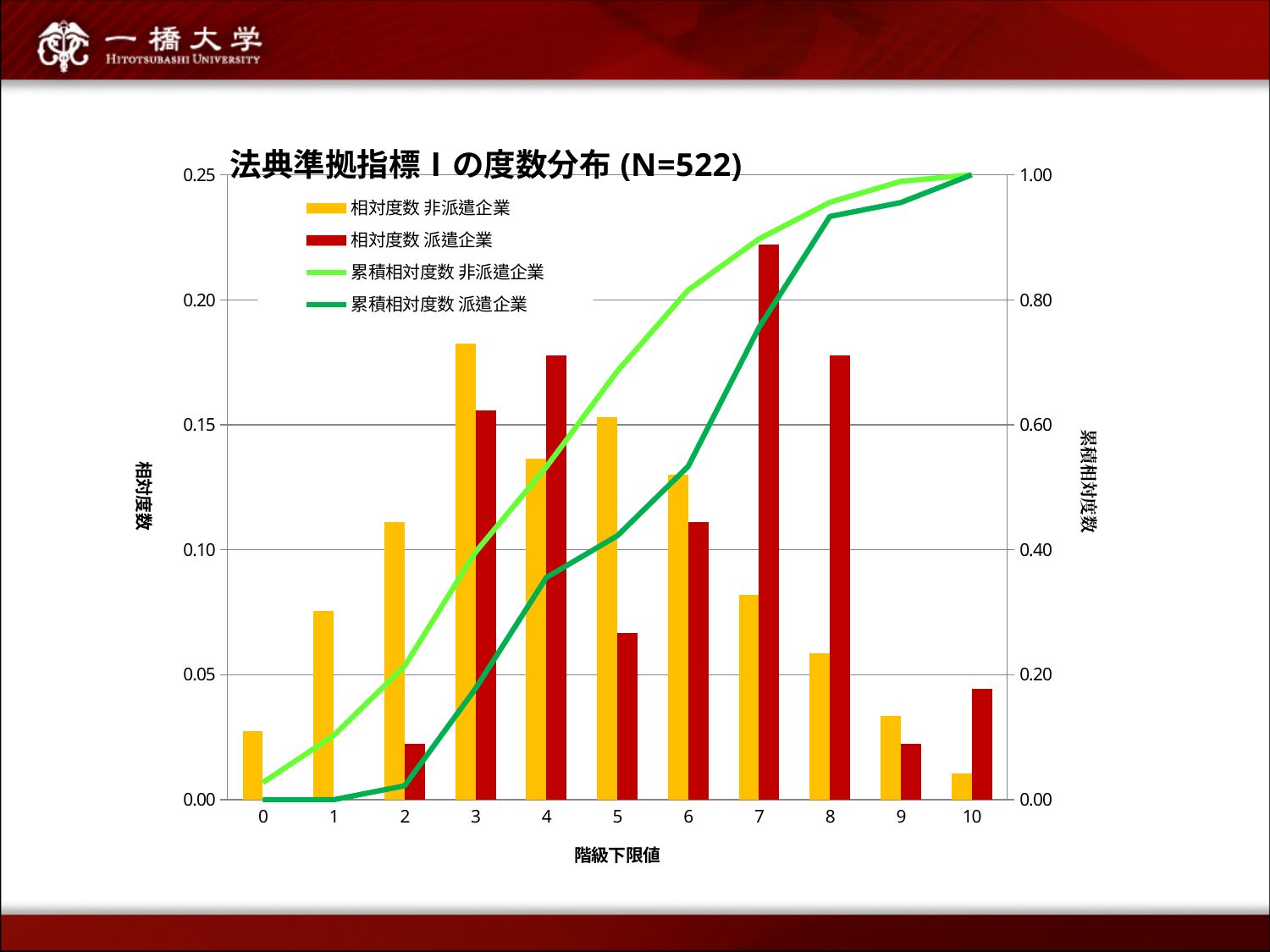
At 階級下限値 3, which is larger: 相対度数 非派遣企業 or 相対度数 派遣企業? 相対度数 非派遣企業 What is the title of the chart? 法典準拠指標 I の度数分布 (N=522) At which 階級下限値 is the 相対度数 非派遣企業 bar highest? 3 How many series does the legend list? 4 At which 階級下限値 is the 相対度数 非派遣企業 bar lowest? 10 At which 階級下限値 is the 相対度数 派遣企業 bar highest? 7 Is the 累積相対度数 非派遣企業 value at 階級下限値 5 greater or less than 0.60? greater Is the 相対度数 派遣企業 value at 階級下限値 7 greater or less than 0.20? greater What kind of chart is this? Combined bar and line chart Is the 相対度数 派遣企業 value at 階級下限値 5 greater or less than 0.10? less Do the 累積相対度数 lines rise or fall as 階級下限値 increases? rise How many categories are shown on the x axis (階級下限値)? 11